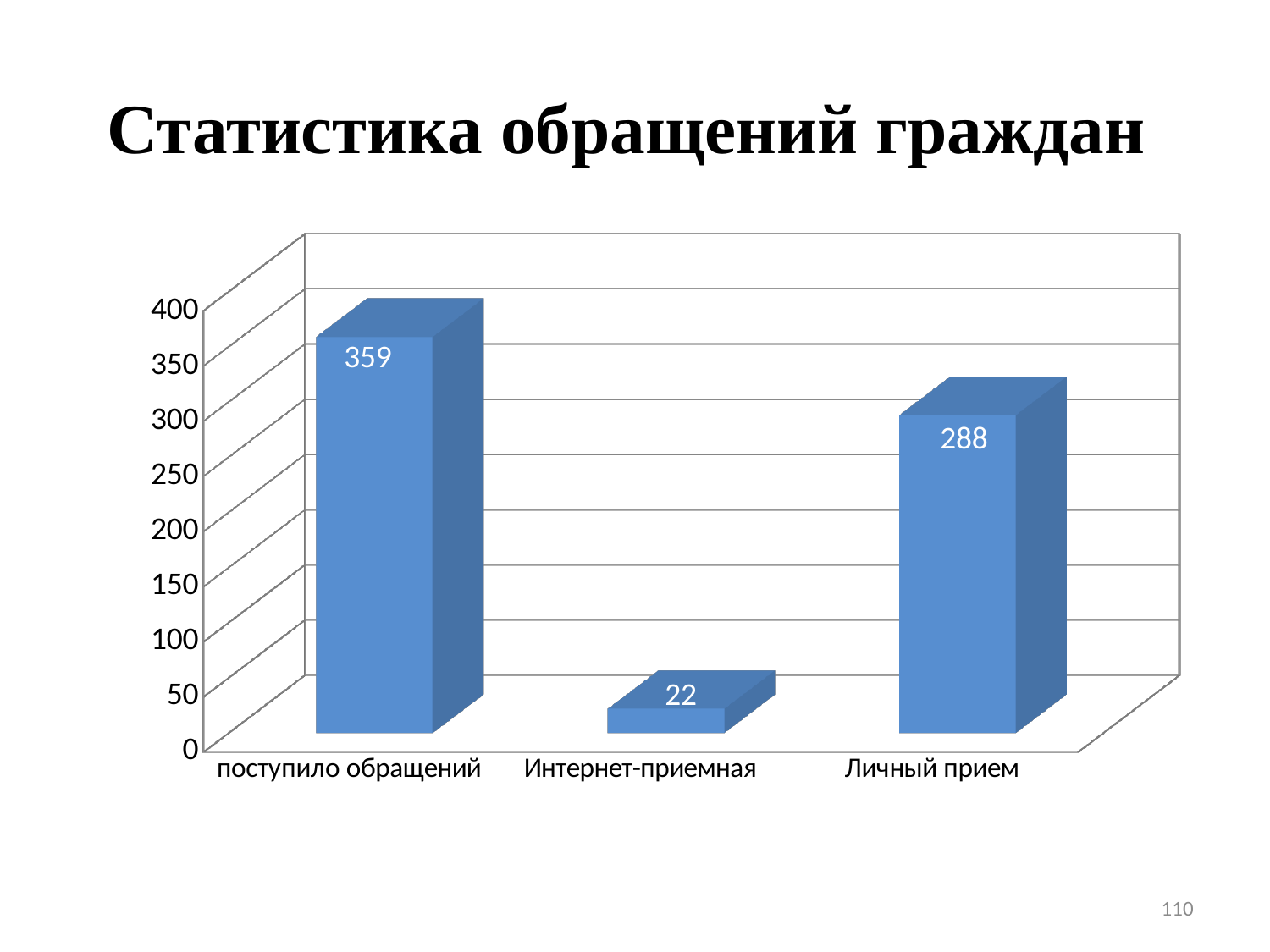
What is the title of the slide? Статистика обращений граждан What is the difference between the values for поступило обращений and Личный прием? 71 What is the value for поступило обращений? 359 What kind of chart is shown on the slide? bar chart Which category has the highest value? поступило обращений Which category has the lowest value? Интернет-приемная What is the difference between the values for Личный прием and Интернет-приемная? 266 What is the value for Личный прием? 288 Is the value for Личный прием greater or less than 250? greater What is the value for Интернет-приемная? 22 How many categories are shown on the chart? 3 Which is larger, the value for Личный прием or the value for Интернет-приемная? Личный прием